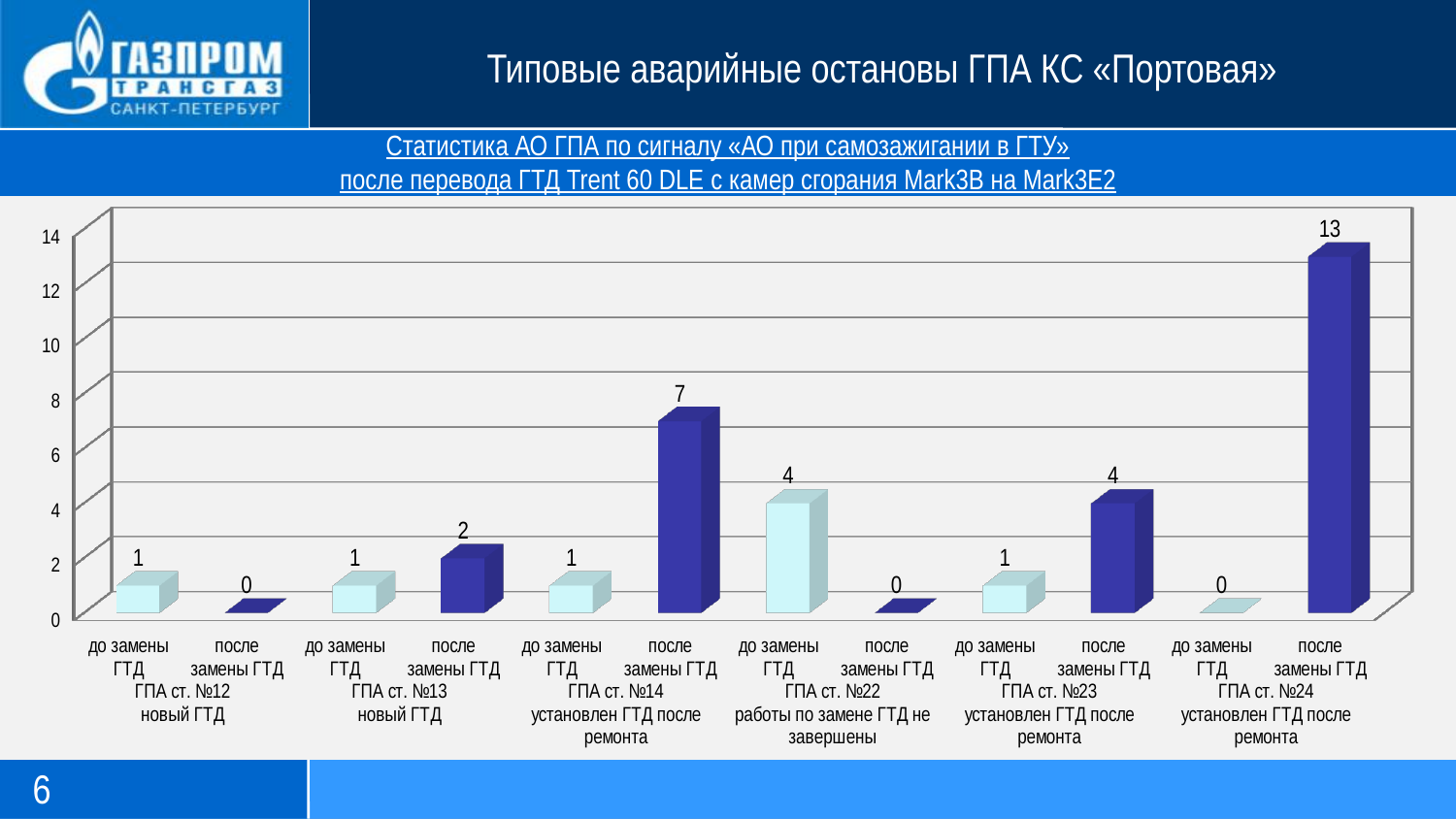
What is the value for "после замены ГТД" at ГПА ст. №24? 13 Is the value for "после замены ГТД" at ГПА ст. №24 greater or less than 12? greater How many bars are plotted in the chart? 12 What is the value for "после замены ГТД" at ГПА ст. №13? 2 What is the difference between the "до замены ГТД" and "после замены ГТД" values at ГПА ст. №23? 3 What is the maximum value shown on the vertical axis of the chart? 14 What is the difference between the "после замены ГТД" value at ГПА ст. №24 and the "после замены ГТД" value at ГПА ст. №14? 6 What is the value for "до замены ГТД" at ГПА ст. №22? 4 What is the value for "после замены ГТД" at ГПА ст. №14? 7 What type of chart is shown on the slide? bar chart Which bar has the highest value in the chart? после замены ГТД, ГПА ст. №24 Which is larger: the "до замены ГТД" value at ГПА ст. №22 or the "после замены ГТД" value at ГПА ст. №23? They are equal (4)